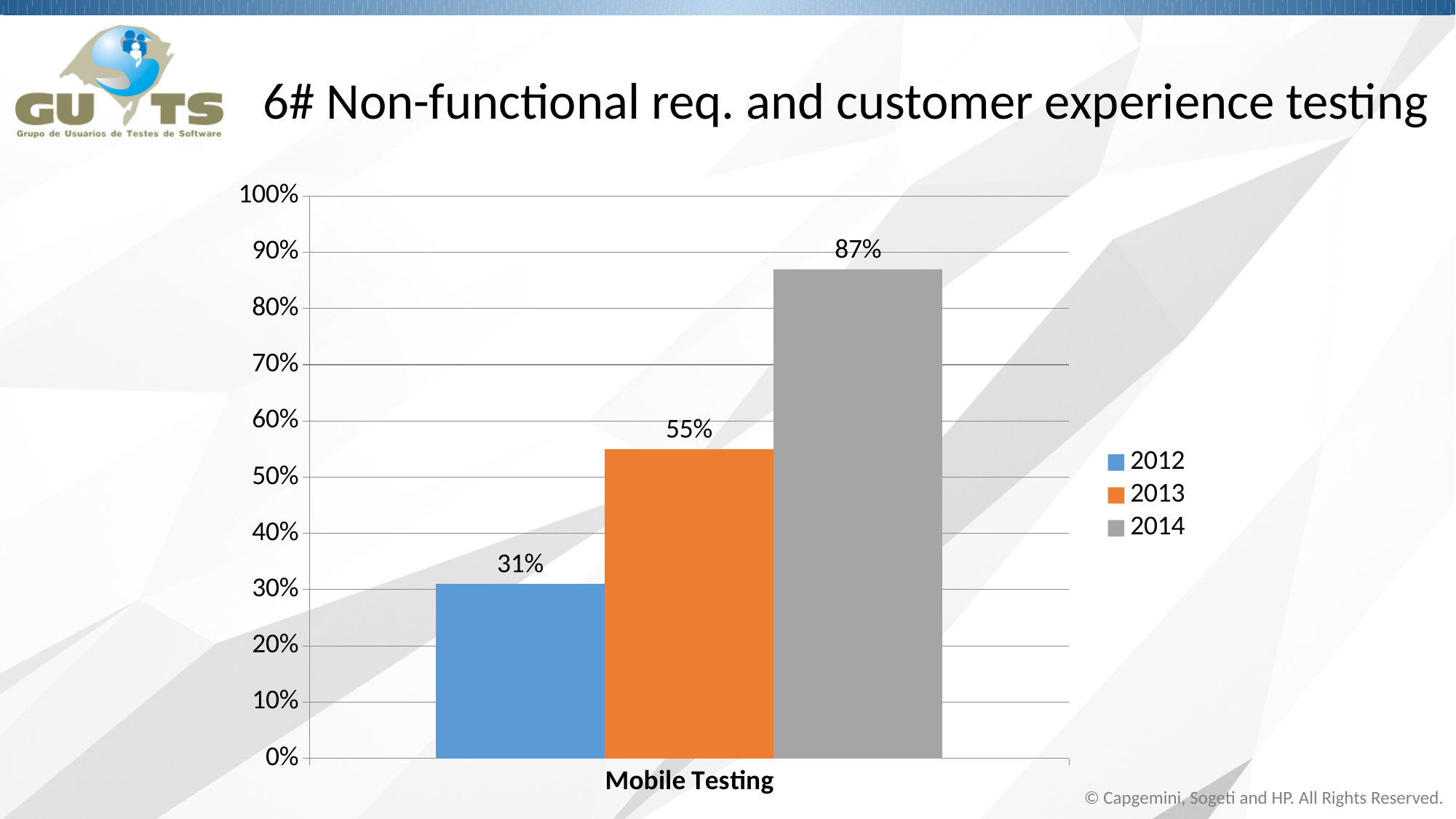
Which year has the highest value for Mobile Testing? 2014 Which year has the lowest value for Mobile Testing? 2012 What is the value for 2014 in the Mobile Testing chart? 87% What is the difference between the 2014 and 2012 values for Mobile Testing? 56% How many series does the legend list? 3 Is the value for 2013 greater or less than 50%? greater What is the difference between the 2013 and 2012 values for Mobile Testing? 24% What is the category label shown on the x axis? Mobile Testing What is the value for 2012 in the Mobile Testing chart? 31% What is the value for 2013 in the Mobile Testing chart? 55% Which is larger for Mobile Testing, the 2013 value or the 2014 value? 2014 What kind of chart is shown on the slide? Bar chart